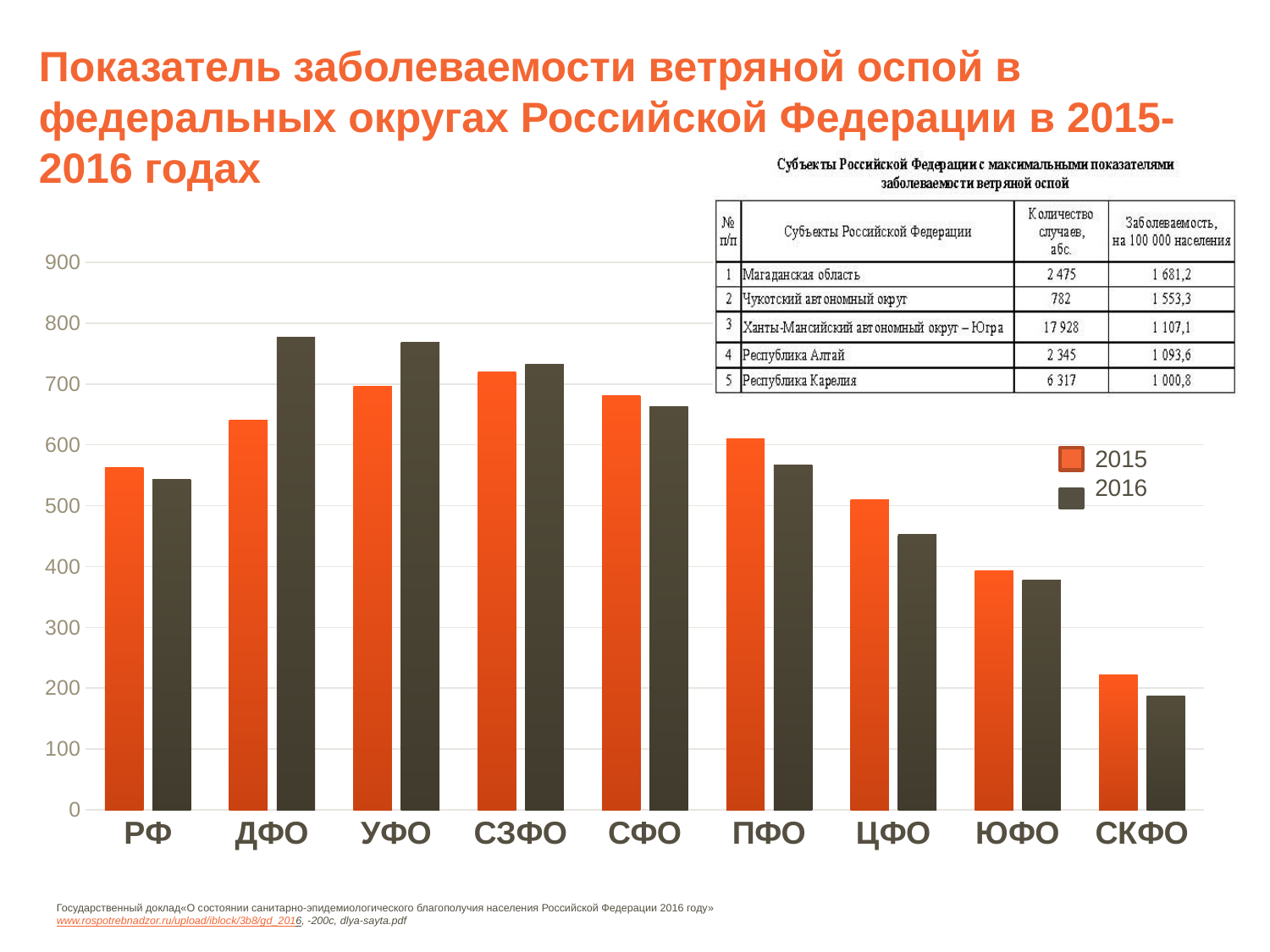
How many series does the legend of the bar chart list? 2 Which category has the lowest value for 2015 in the bar chart? СКФО Is the 2016 value for ЦФО greater or less than 500? less Which colour represents the 2015 series in the legend? orange How many federal districts (categories) are shown on the x axis of the bar chart? 9 For ДФО, which is larger: the 2015 value or the 2016 value? 2016 Is the 2015 value for СКФО greater or less than 300? less For ЦФО, which is larger: the 2015 value or the 2016 value? 2015 What kind of chart is shown on the slide? bar chart Is the 2016 value for ДФО greater or less than 700? greater Moving from СЗФО to СКФО along the x axis, do the 2016 values rise or fall? fall Which category has the lowest value for 2016 in the bar chart? СКФО